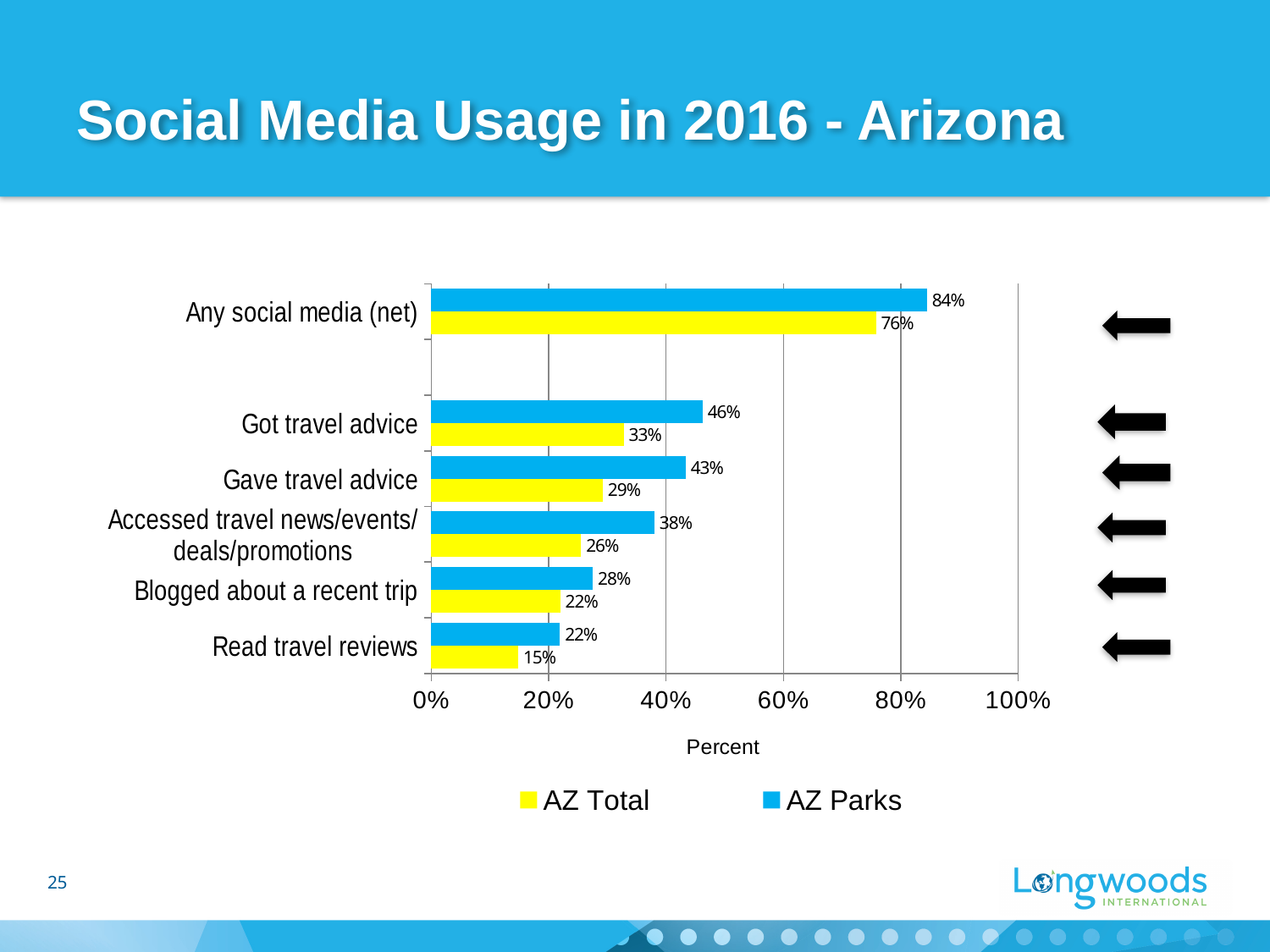
What is the AZ Parks value for Blogged about a recent trip? 28% How many categories are shown on the chart? 6 What is the title of the chart? Social Media Usage in 2016 - Arizona Which category has the lowest AZ Total value? Read travel reviews How many series does the legend list? 2 Which category has the highest AZ Parks value? Any social media (net) What is the difference between the AZ Parks and AZ Total values for Gave travel advice? 14% What is the AZ Total value for Got travel advice? 33% What kind of chart is shown on the slide? Bar chart What is the AZ Parks value for Any social media (net)? 84% What is the AZ Total value for Read travel reviews? 15% Which is larger for Accessed travel news/events/deals/promotions: AZ Total or AZ Parks? AZ Parks